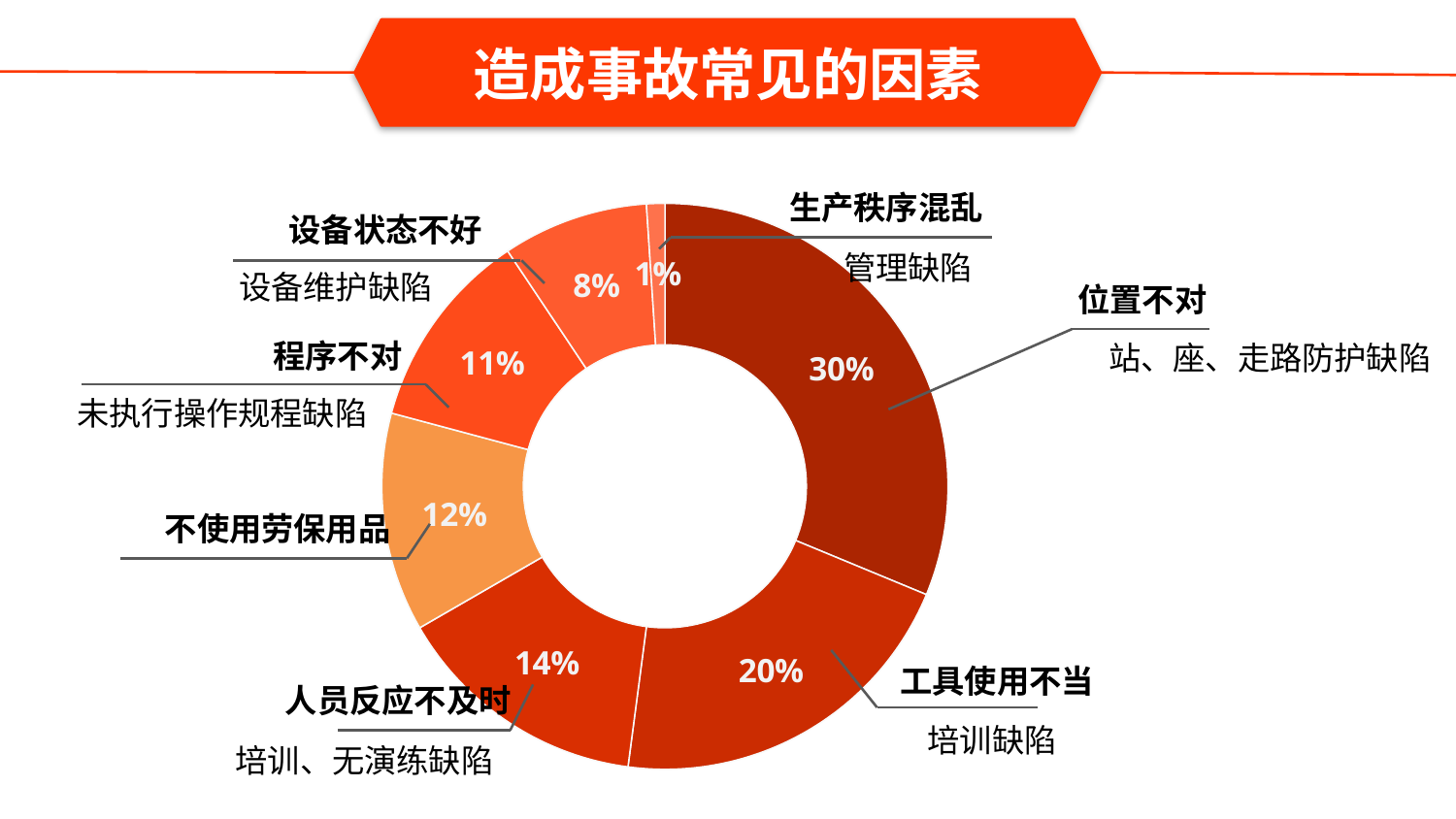
What percentage is shown for 设备状态不好? 8% Which factor has the largest share of the chart? 位置不对 What percentage is shown for 不使用劳保用品? 12% Which factor has the smallest share of the chart? 生产秩序混乱 What is the title of the chart on the slide? 造成事故常见的因素 What kind of chart is shown on the slide? Pie (donut) chart How many factors (slices) are shown in the chart? 7 What percentage is shown for 位置不对? 30% What percentage is shown for 工具使用不当? 20% Which has a larger share, 程序不对 or 不使用劳保用品? 不使用劳保用品 What percentage is shown for 人员反应不及时? 14% What is the difference between the shares of 位置不对 and 工具使用不当? 10%